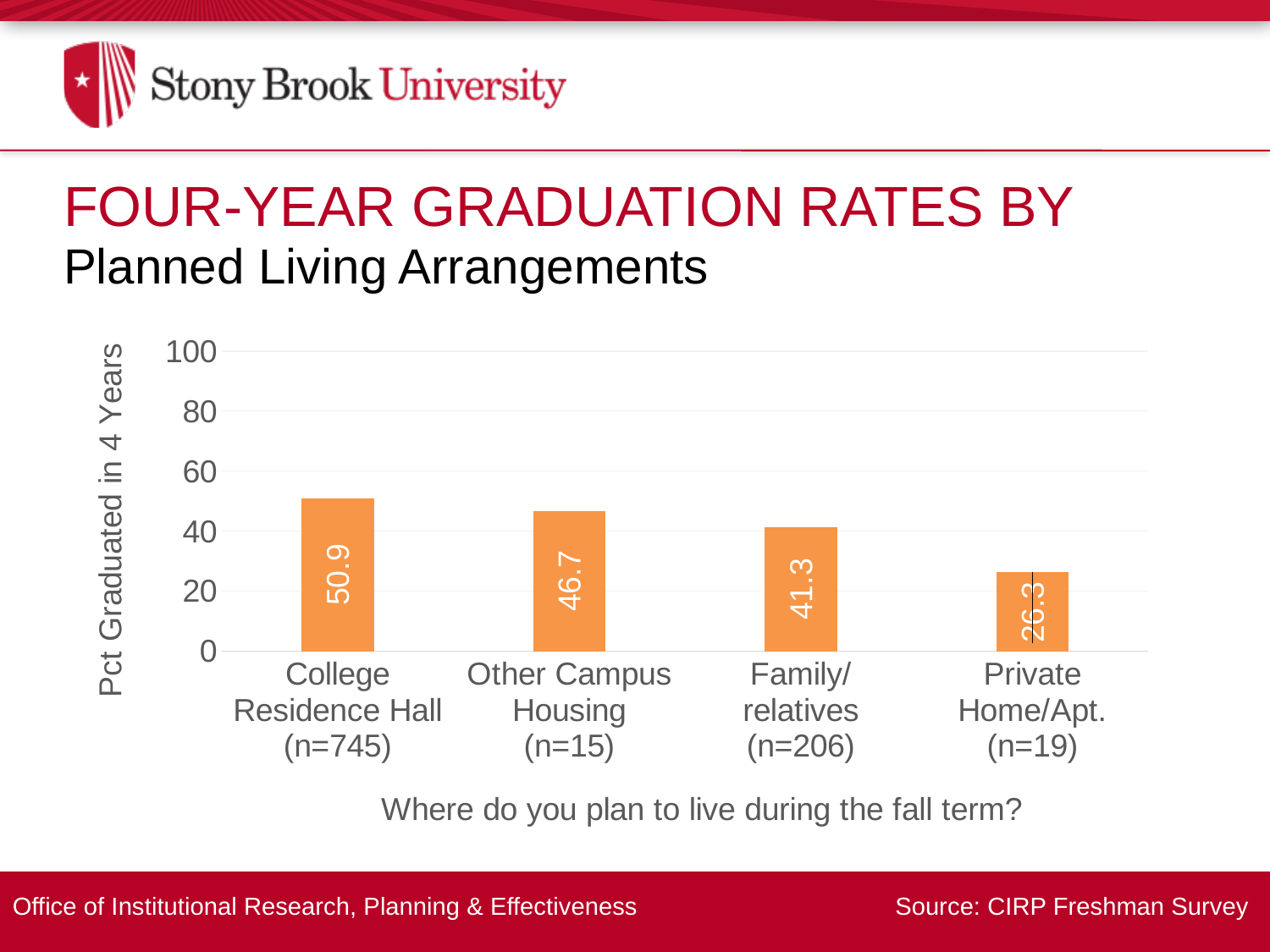
Which planned living arrangement has the highest four-year graduation rate? College Residence Hall Which has a higher four-year graduation rate: Other Campus Housing or Family/relatives? Other Campus Housing Which planned living arrangement has the lowest four-year graduation rate? Private Home/Apt. What is the difference in four-year graduation rate between College Residence Hall and Private Home/Apt.? 24.6 What is the four-year graduation rate for students planning to live in Other Campus Housing? 46.7 What is the four-year graduation rate for students planning to live with Family/relatives? 41.3 What is the four-year graduation rate for students planning to live in a Private Home/Apt.? 26.3 What kind of chart is shown on the slide? bar chart What is the label on the vertical axis of the chart? Pct Graduated in 4 Years What is the four-year graduation rate for students planning to live in a College Residence Hall? 50.9 Is the four-year graduation rate for Family/relatives greater or less than 60? less How many planned living arrangement categories are shown in the chart? 4